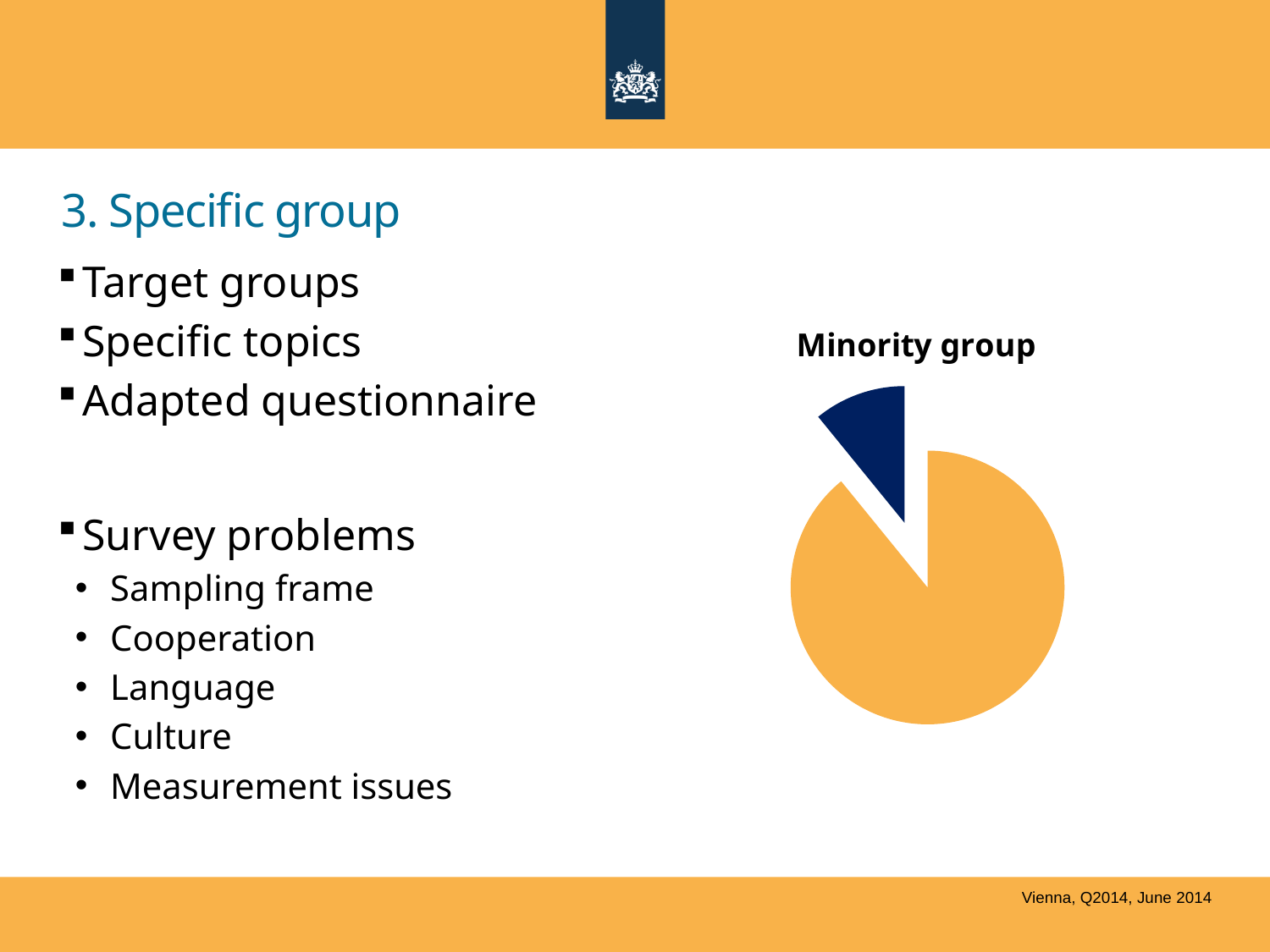
What is the title of the pie chart? Minority group How many slices does the pie chart have? 2 What kind of chart is shown on the slide? pie chart Which slice of the pie chart is larger, the orange one or the dark blue one? the orange one What colour is the slice that is pulled out from the rest of the pie chart? dark blue